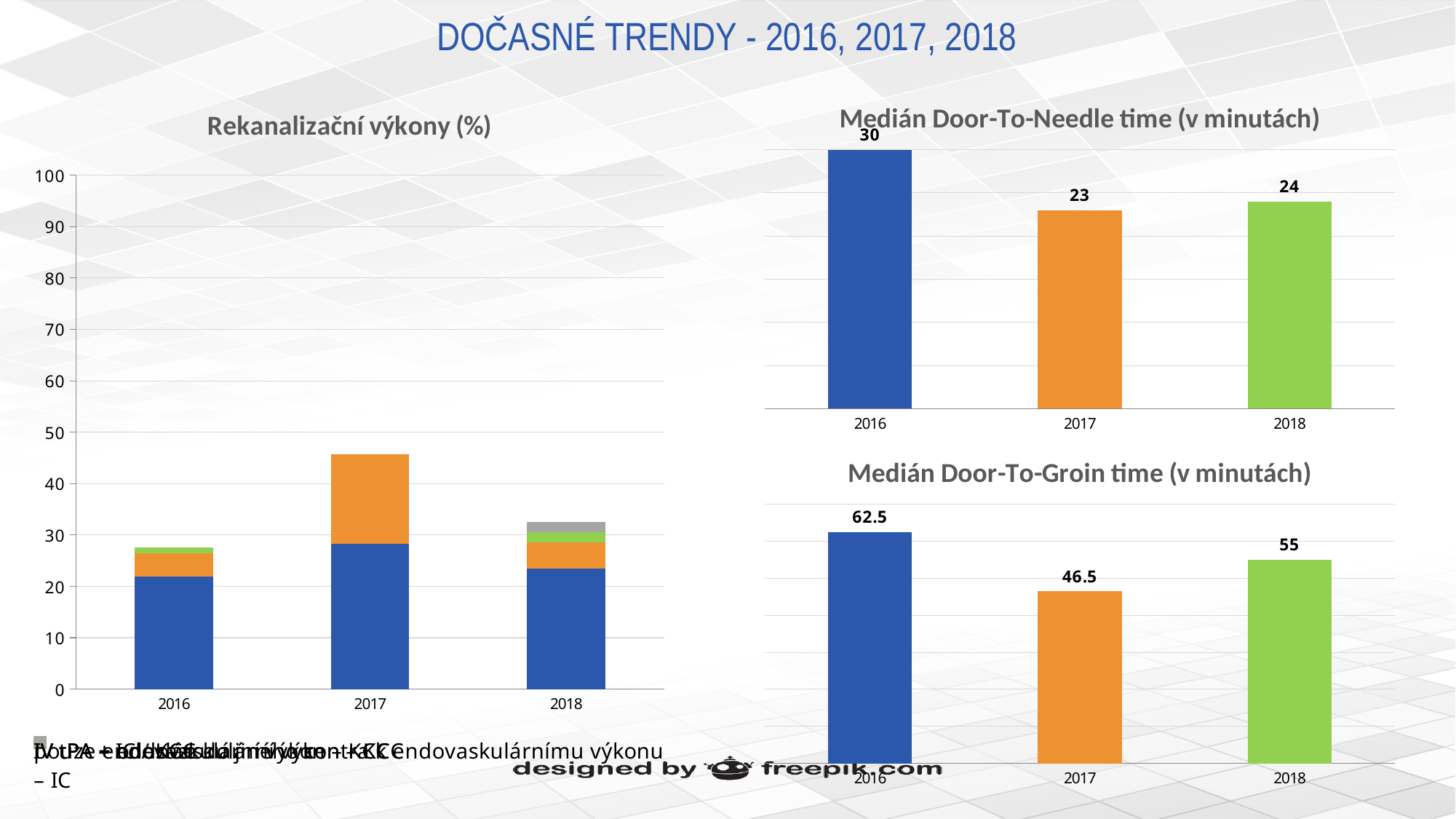
In the Medián Door-To-Needle time chart, what is the value for 2016? 30 In the Medián Door-To-Groin time chart, which year has the highest value? 2016 In the Medián Door-To-Groin time chart, what is the value for 2018? 55 What kind of chart is the Rekanalizační výkony (%) chart? Stacked bar chart In the Medián Door-To-Needle time chart, what is the value for 2017? 23 In the Medián Door-To-Needle time chart, which is larger, the value for 2017 or for 2018? 2018 In the Medián Door-To-Needle time chart, what is the difference between the 2016 and 2017 values? 7 In the Rekanalizační výkony (%) chart, is the total stacked value for 2017 greater or less than 40? greater In the Medián Door-To-Needle time chart, which year has the lowest value? 2017 In the Rekanalizační výkony (%) chart, how many years are shown on the x axis? 3 In the Medián Door-To-Groin time chart, what is the value for 2016? 62.5 In the Medián Door-To-Groin time chart, what is the difference between the 2018 and 2017 values? 8.5